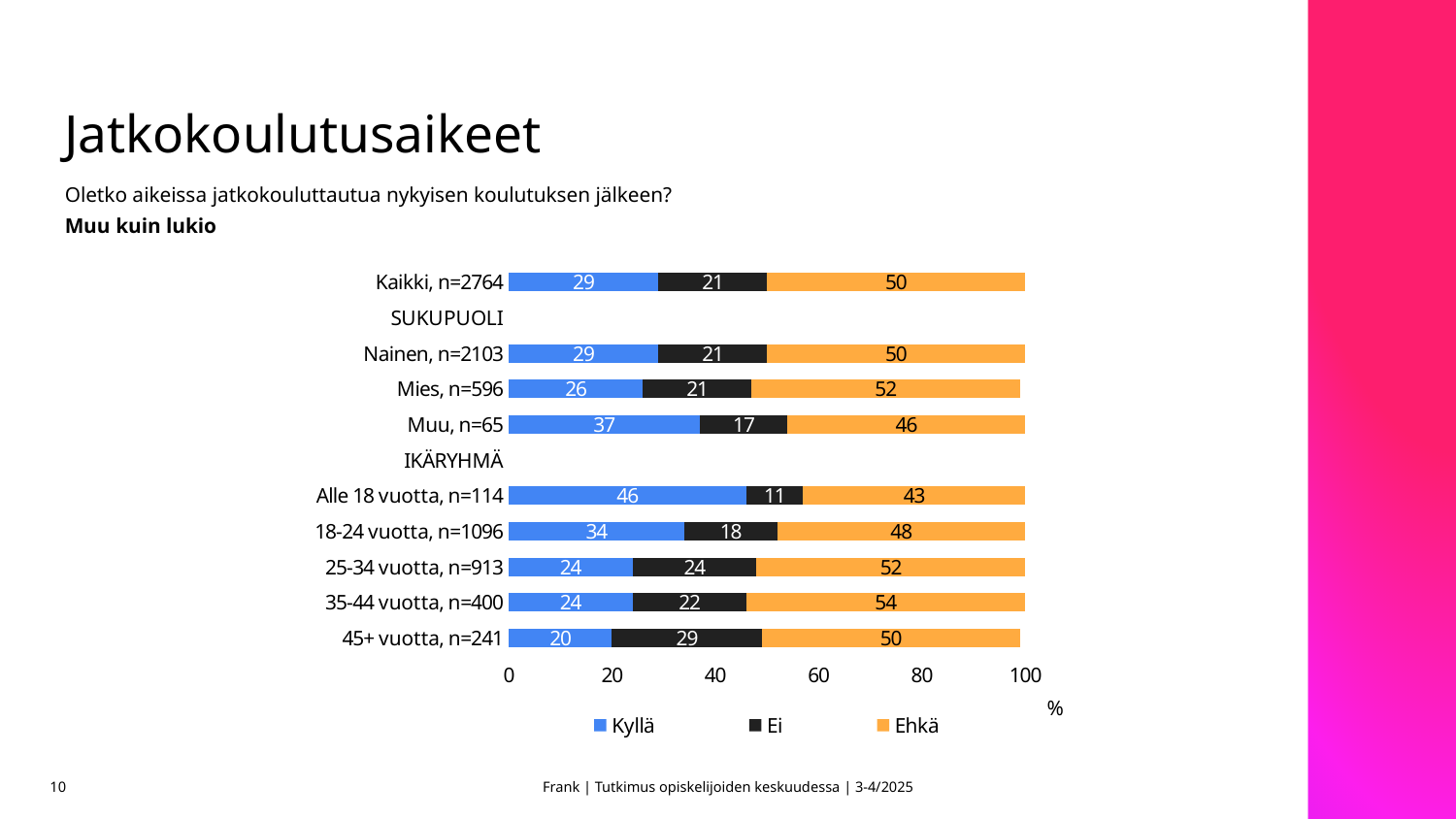
Which category has the lowest Ei value? Alle 18 vuotta, n=114 What kind of chart is shown on the slide? Stacked bar chart What is the Kyllä value for Kaikki, n=2764? 29 What is the Ei value for Muu, n=65? 17 Which is larger: the Ei value for 45+ vuotta, n=241 or the Ei value for 25-34 vuotta, n=913? 45+ vuotta, n=241 Which category has the highest Kyllä value? Alle 18 vuotta, n=114 What is the difference between the Kyllä values for Muu, n=65 and Mies, n=596? 11 What is the Ehkä value for 35-44 vuotta, n=400? 54 What is the total of the stacked bar for Alle 18 vuotta, n=114? 100 Which series is shown in orange in the legend? Ehkä How many series does the legend list? 3 What is the Kyllä value for 18-24 vuotta, n=1096? 34